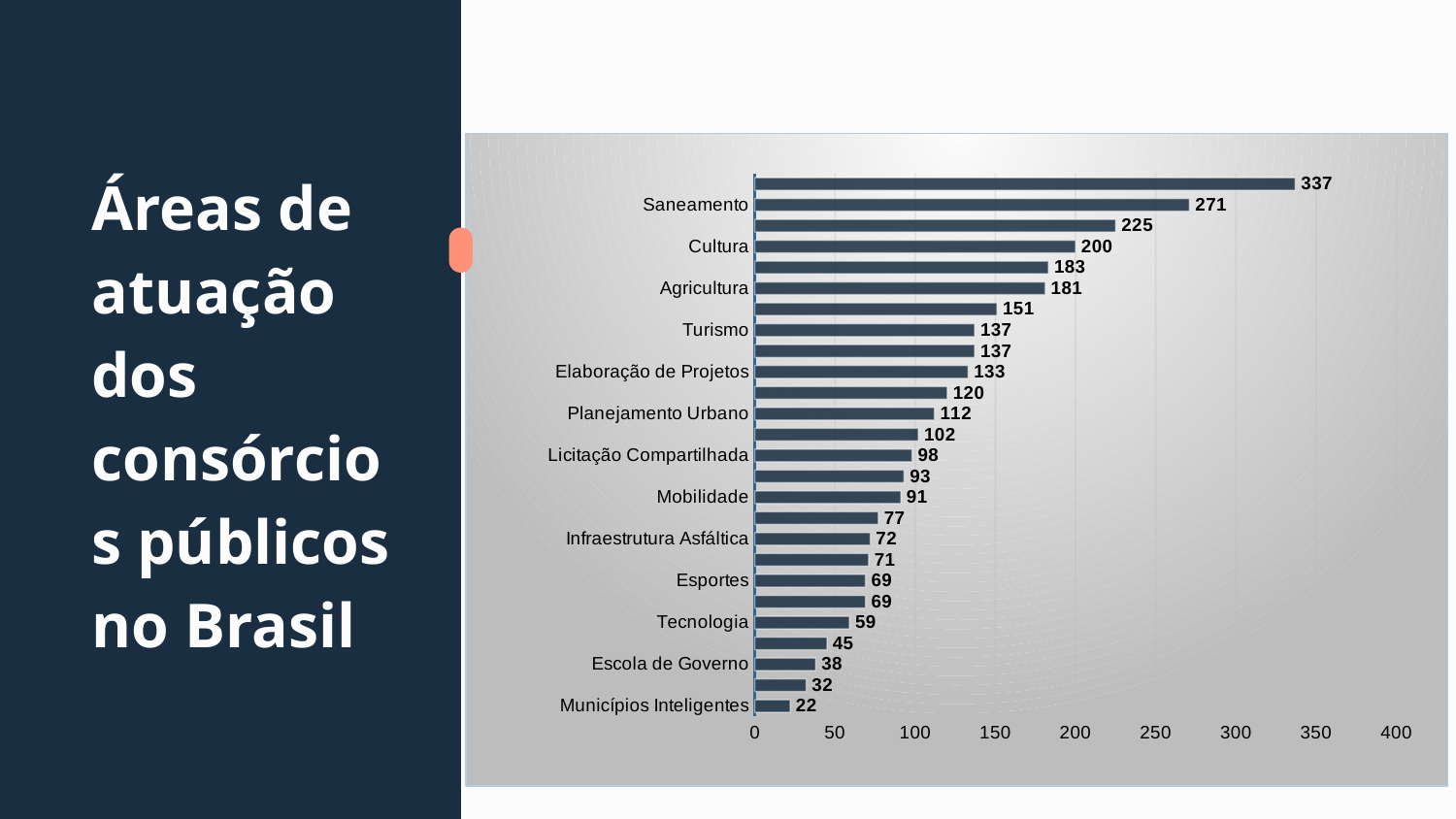
What is the value for Agricultura? 181 What is the difference between the values for Saneamento and Cultura? 71 What is the value for Cultura? 200 What is the value for Escola de Governo? 38 What is the value for Saneamento? 271 Is the value for Licitação Compartilhada greater or less than 100? less Which is larger, the value for Mobilidade or the value for Esportes? Mobilidade What is the difference between the values for Turismo and Tecnologia? 78 Which labelled category has the lowest value? Municípios Inteligentes How many bars are plotted in the chart? 26 What is the value for Planejamento Urbano? 112 What type of chart is shown on the slide? bar chart